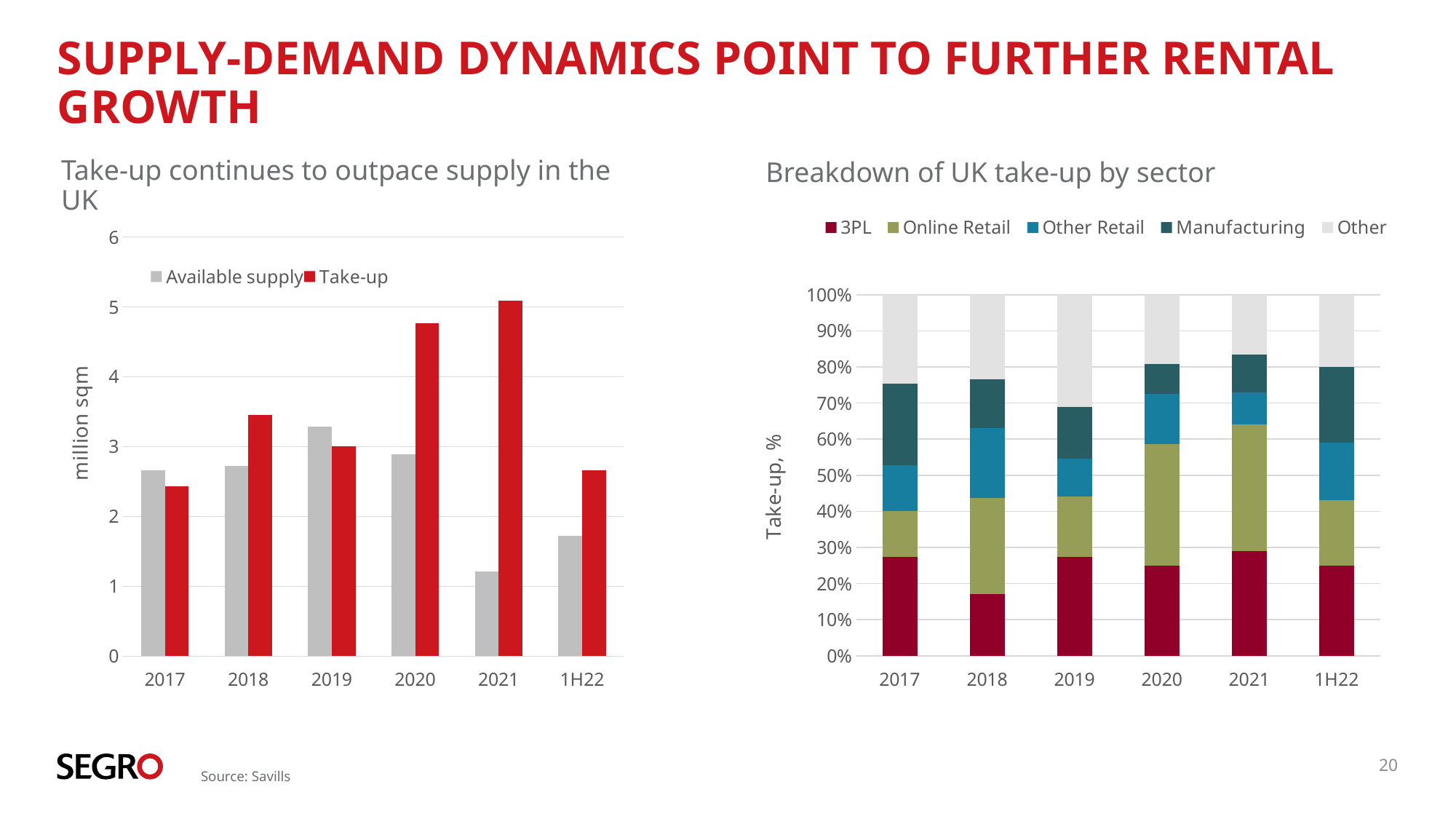
How many series does the legend of the 'Take-up continues to outpace supply in the UK' chart list? 2 In the 'Take-up continues to outpace supply in the UK' chart, is the Available supply value for 2021 greater or less than 2? less In the 'Take-up continues to outpace supply in the UK' chart, is the Take-up value for 2020 greater or less than 4? greater In the 'Breakdown of UK take-up by sector' chart, is the 3PL share for 2018 greater or less than 20%? less What kind of chart is the 'Take-up continues to outpace supply in the UK' chart? bar chart In the 'Take-up continues to outpace supply in the UK' chart, which year has the highest Take-up? 2021 How many periods are shown on the x axis of the 'Breakdown of UK take-up by sector' chart? 6 How many series does the legend of the 'Breakdown of UK take-up by sector' chart list? 5 What is the total of the stacked bar for 2020 in the 'Breakdown of UK take-up by sector' chart? 100% In the 'Take-up continues to outpace supply in the UK' chart, which year has the highest Available supply? 2019 In the 'Take-up continues to outpace supply in the UK' chart, which is larger in 2017, Available supply or Take-up? Available supply In the 'Take-up continues to outpace supply in the UK' chart, which period has the lowest Available supply? 2021